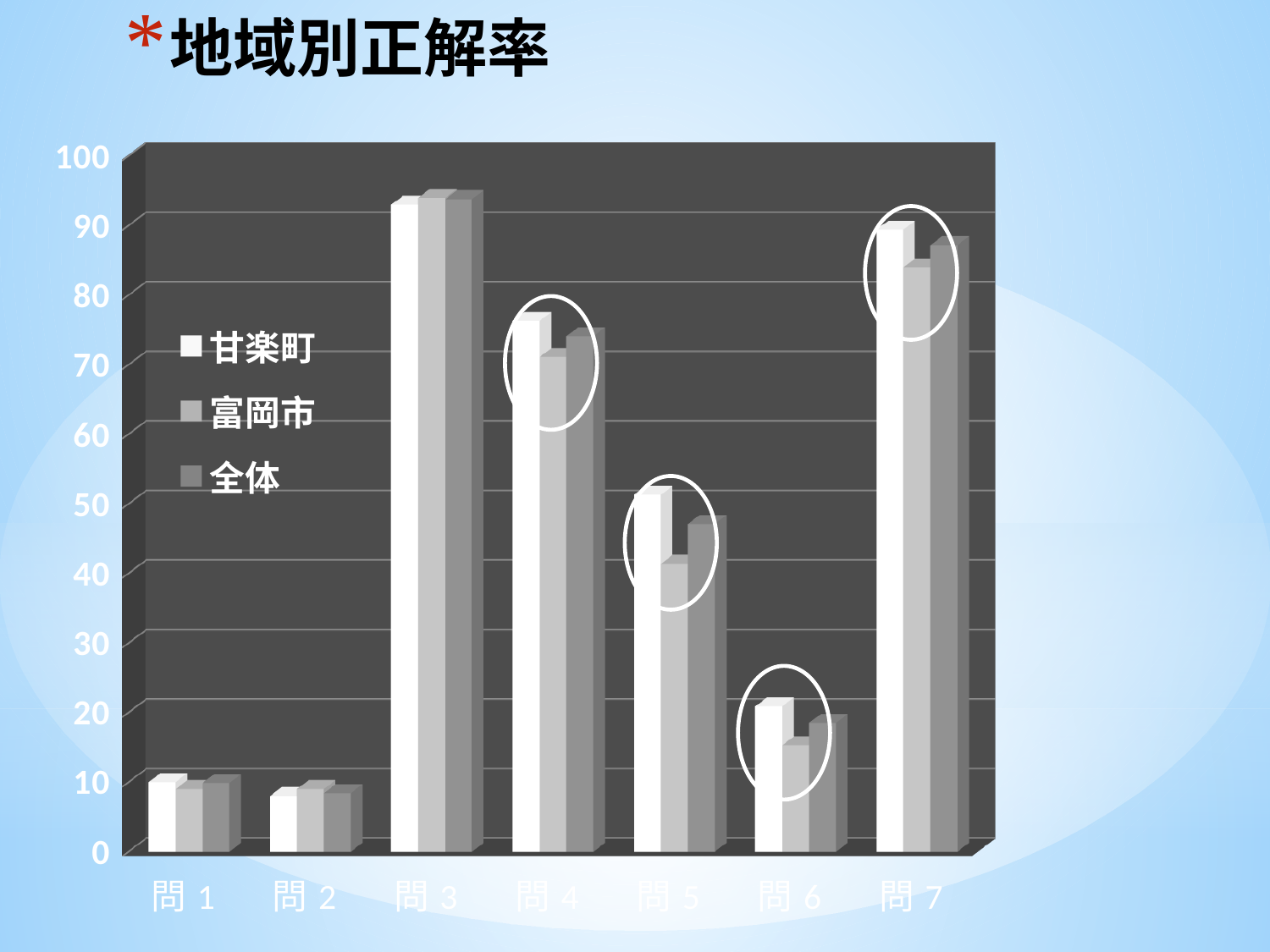
How many series does the chart's legend list? 3 Is the 甘楽町 value for 問4 greater or less than 70? greater For which question is the 富岡市 value highest? 問3 Is the 富岡市 value for 問5 greater or less than 50? less What are the three series listed in the chart's legend? 甘楽町, 富岡市, 全体 Is the 甘楽町 value for 問6 greater or less than 30? less For 問6, which is larger: the 全体 value or the 富岡市 value? 全体 What is the title of the slide containing the chart? 地域別正解率 What kind of chart is shown on the slide? bar chart How many question categories are shown on the x axis of the chart? 7 For 問5, which is larger: the 甘楽町 value or the 富岡市 value? 甘楽町